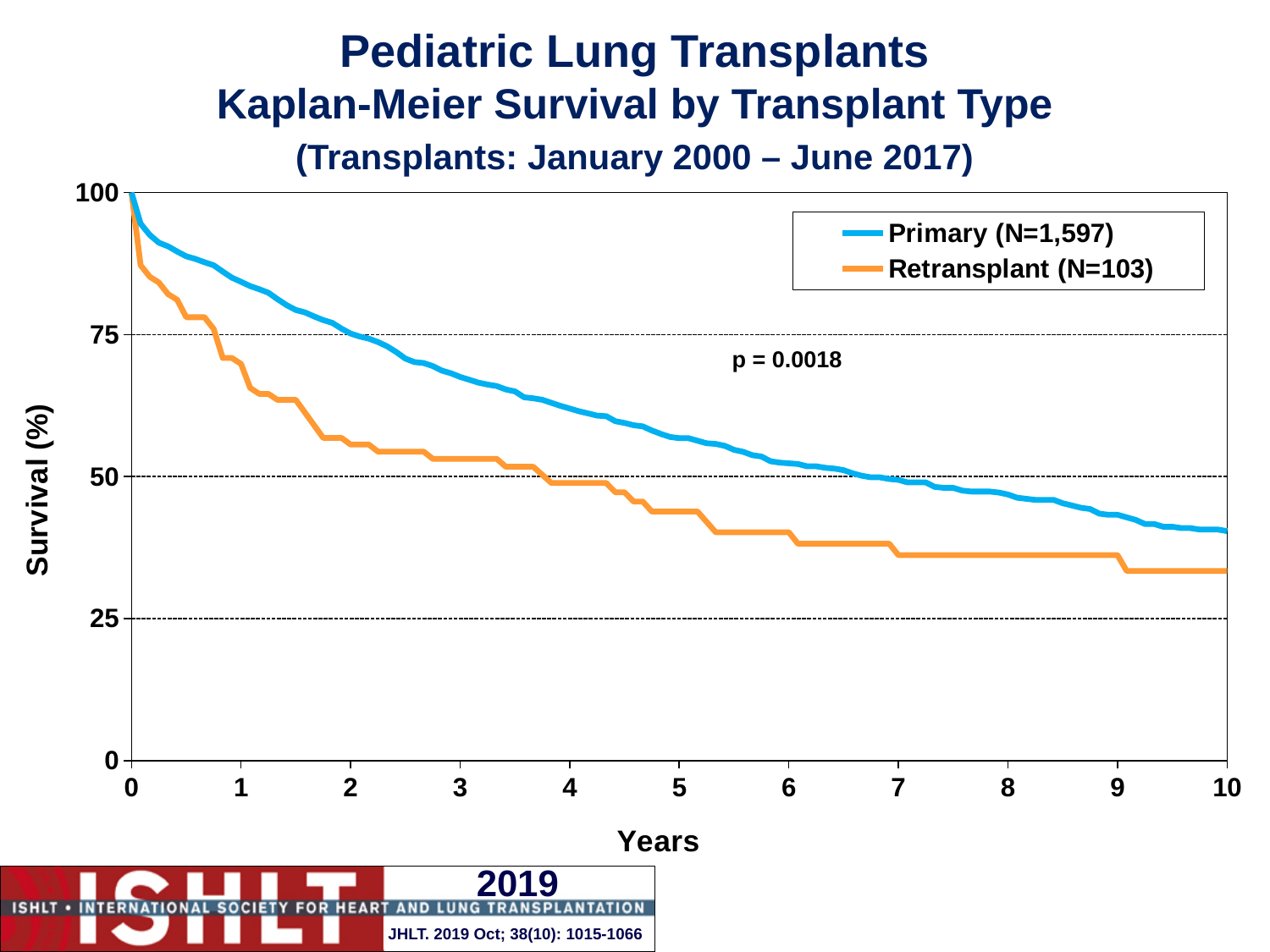
What kind of chart is shown on the slide? Line chart Is the survival value for the Retransplant group at 5 years greater or less than 50? less Which group has the lower survival at 10 years? Retransplant How many series does the legend list? 2 Is the survival value for the Retransplant group at 9 years greater or less than 25? greater Do the survival curves rise or fall as years increase? Fall Is the survival value for the Primary group at 10 years greater or less than 50? less What is the N for the Primary group shown in the legend? 1,597 At 5 years, which group has higher survival, Primary or Retransplant? Primary Which two series are plotted in the chart? Primary and Retransplant